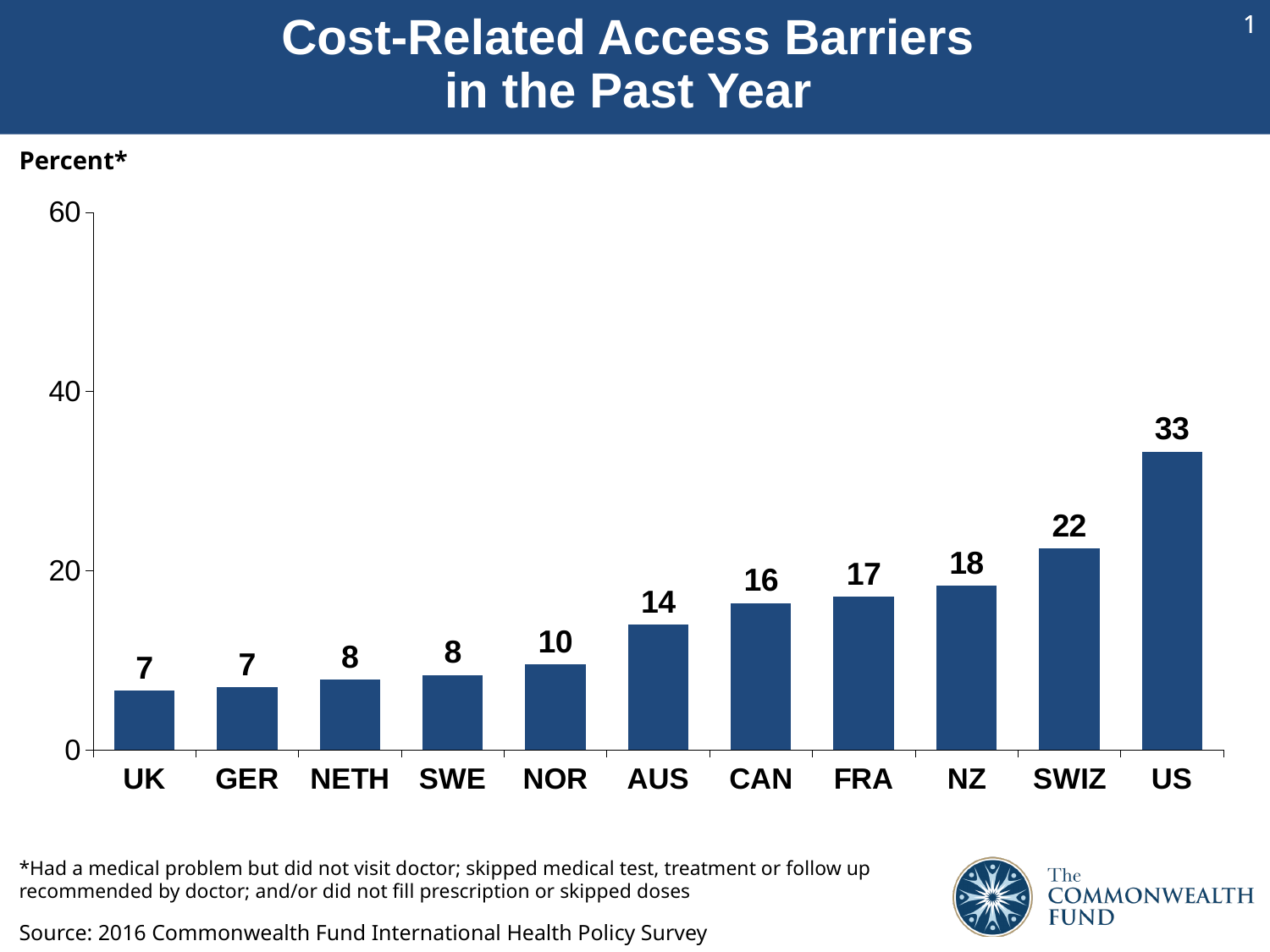
What is the value for the US? 33 What is the difference between the values for NZ and AUS? 4 Which country has the highest value? US What kind of chart is shown on the slide? bar chart Is the value for SWIZ greater or less than 20? greater What is the difference between the values for the US and SWIZ? 11 What is the value for CAN? 16 Do the values generally rise or fall from left to right across the countries? rise Which is larger, the value for FRA or the value for NETH? FRA How many countries are shown on the chart? 11 What is the value for NOR? 10 What is the title of the chart? Cost-Related Access Barriers in the Past Year